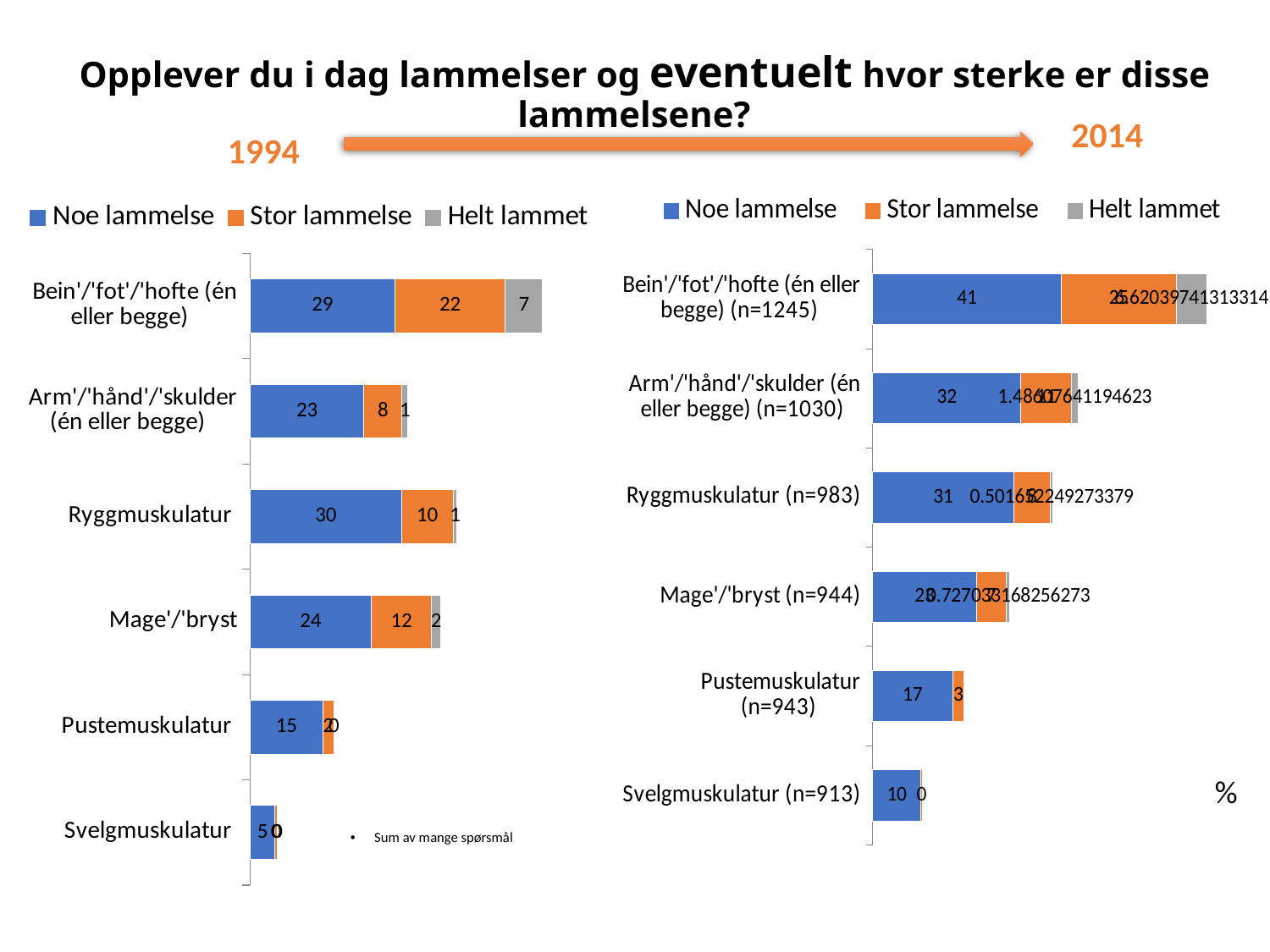
In the 1994 chart, what is the value of Noe lammelse for Bein'/'fot'/'hofte (én eller begge)? 29 In the 1994 chart, what is the value of Stor lammelse for Mage'/'bryst? 12 In the 1994 chart, what is the total of the stacked bar for Arm'/'hånd'/'skulder (én eller begge)? 32 In the 1994 chart, which category has the highest Noe lammelse value? Ryggmuskulatur In the 2014 chart, which is larger, the Noe lammelse value for Arm'/'hånd'/'skulder (én eller begge) (n=1030) or for Svelgmuskulatur (n=913)? Arm'/'hånd'/'skulder (én eller begge) (n=1030) In the 2014 chart, what is the value of Stor lammelse for Pustemuskulatur (n=943)? 3 How many series does the legend of the 2014 chart list? 3 In the 1994 chart, which category has the lowest Noe lammelse value? Svelgmuskulatur In the 1994 chart, what is the difference between the Stor lammelse values for Bein'/'fot'/'hofte (én eller begge) and Ryggmuskulatur? 12 What type of chart is the 1994 chart? Stacked bar chart In the 2014 chart, what is the value of Noe lammelse for Bein'/'fot'/'hofte (én eller begge) (n=1245)? 41 In the 1994 chart, what is the value of Helt lammet for Bein'/'fot'/'hofte (én eller begge)? 7